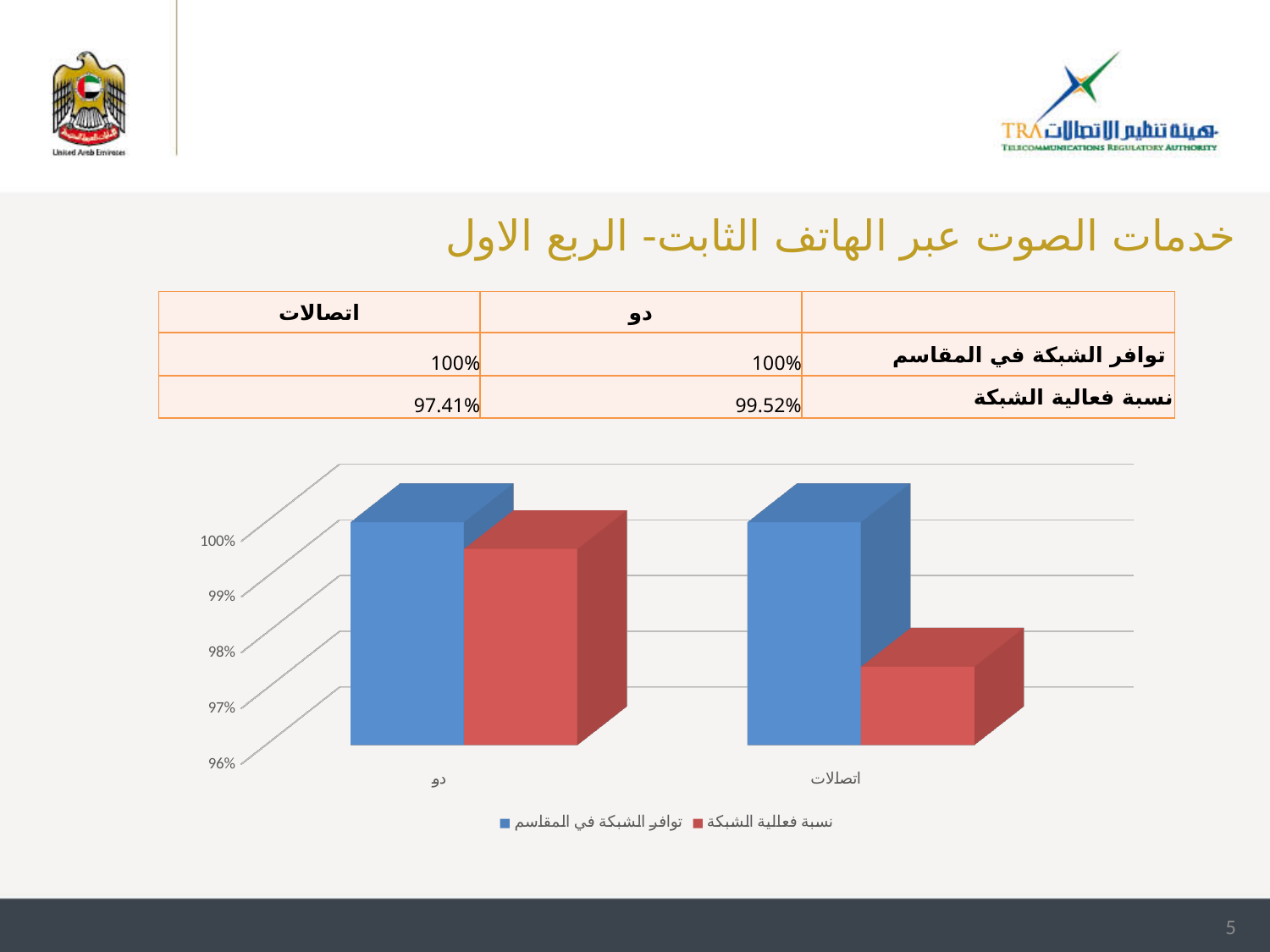
What is the value of توافر الشبكة في المقاسم for اتصالات? 100% What is the value of نسبة فعالية الشبكة for دو? 99.52% Is the نسبة فعالية الشبكة value for دو greater or less than 99%? greater What is the difference between the نسبة فعالية الشبكة values for دو and اتصالات? 2.11% What is the lowest value shown on the vertical axis of the chart? 96% What is the value of توافر الشبكة في المقاسم for دو? 100% Which operator has the higher نسبة فعالية الشبكة, دو or اتصالات? دو How many categories are shown on the x axis of the chart? 2 What is the value of نسبة فعالية الشبكة for اتصالات? 97.41% Is the نسبة فعالية الشبكة value for اتصالات greater or less than 98%? less How many series does the chart legend list? 2 What kind of chart is shown on the slide? bar chart